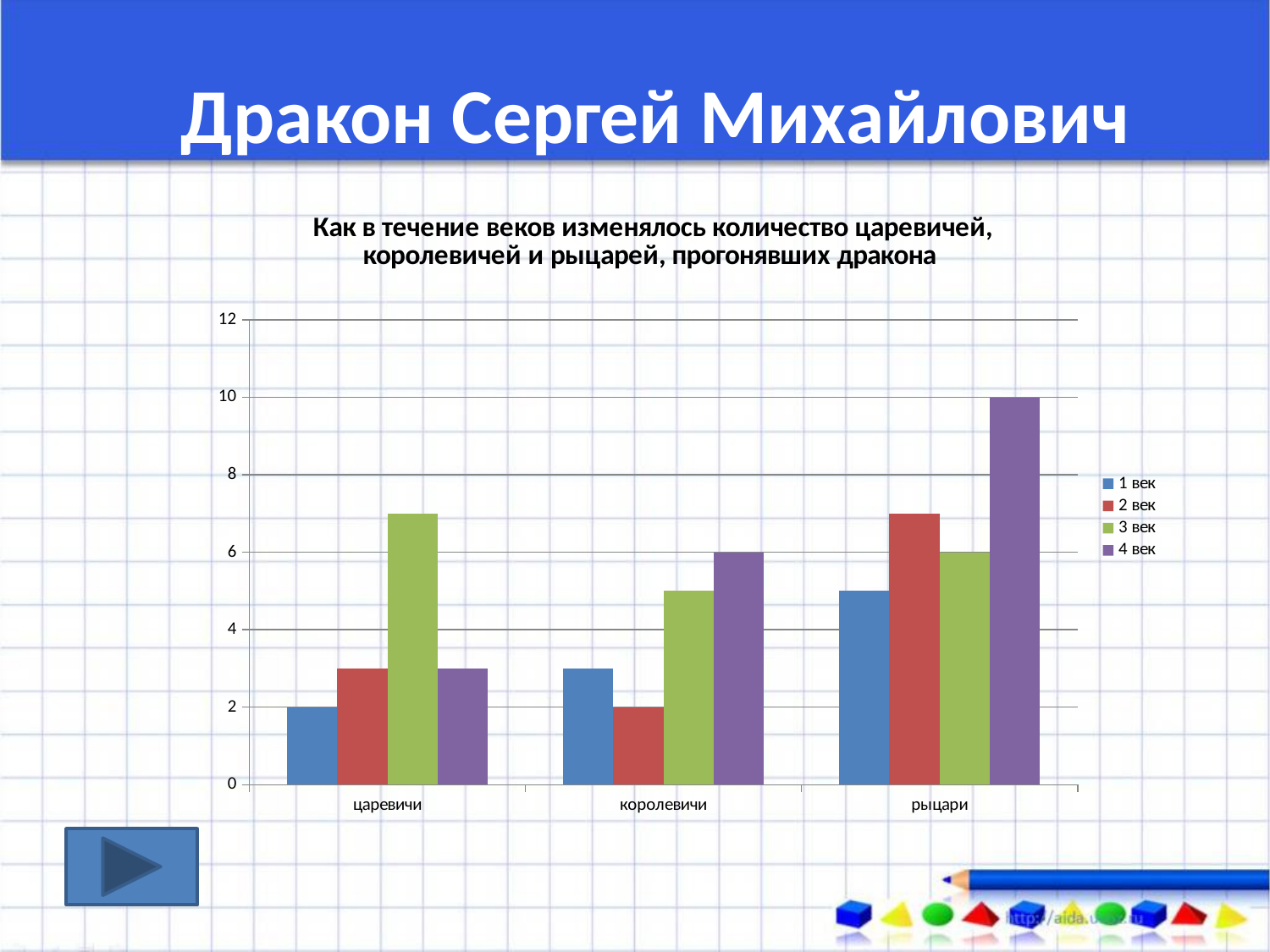
What is the value for 1 век in the царевичи category? 2 What is the value for 4 век in the королевичи category? 6 What is the value for 4 век in the рыцари category? 10 Which series has the highest bar in the рыцари category? 4 век Which series has the lowest bar in the королевичи category? 2 век Is the value for 3 век in the царевичи category greater or less than 6? greater How many series does the legend list? 4 How many categories are shown on the x axis? 3 What is the value for 3 век in the рыцари category? 6 What kind of chart is shown on the slide? bar chart What is the difference between the 4 век bar for рыцари and the 4 век bar for королевичи? 4 Which is larger in the царевичи category: the bar for 3 век or the bar for 4 век? 3 век